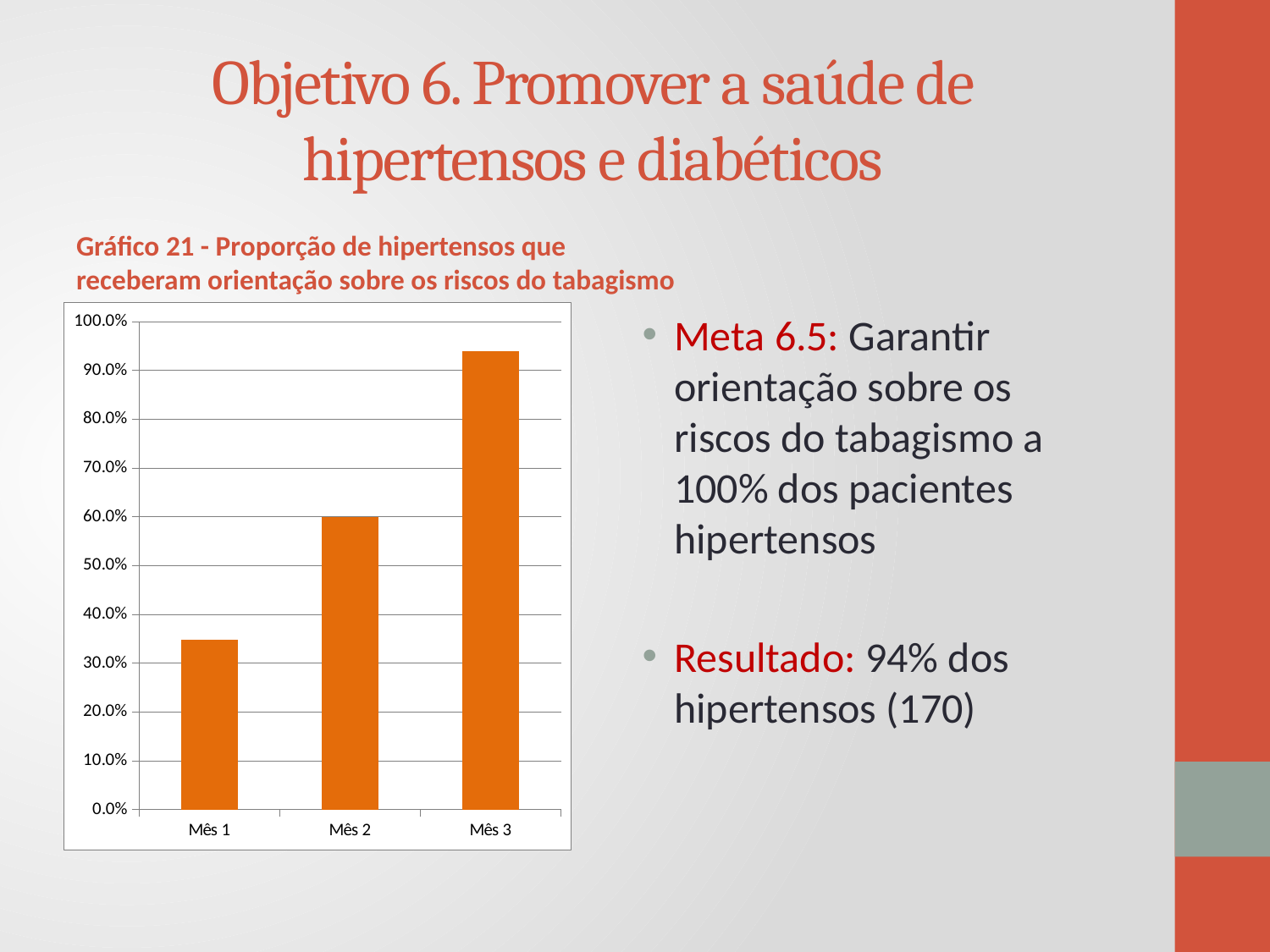
What is the title of the chart (Gráfico 21)? Proporção de hipertensos que receberam orientação sobre os riscos do tabagismo Which month has the highest proportion of hypertensive patients who received guidance on the risks of smoking? Mês 3 How many categories (months) are plotted on the chart? 3 Is the value for Mês 1 greater or less than 30.0%? greater Is the value for Mês 3 greater or less than 100.0%? less What kind of chart is shown on the slide? bar chart Which is larger, the value for Mês 2 or the value for Mês 1? Mês 2 What colour are the bars in the chart? orange Is the value for Mês 3 greater or less than 90.0%? greater Which month has the lowest value on the chart? Mês 1 Do the values rise or fall from Mês 1 to Mês 3? rise